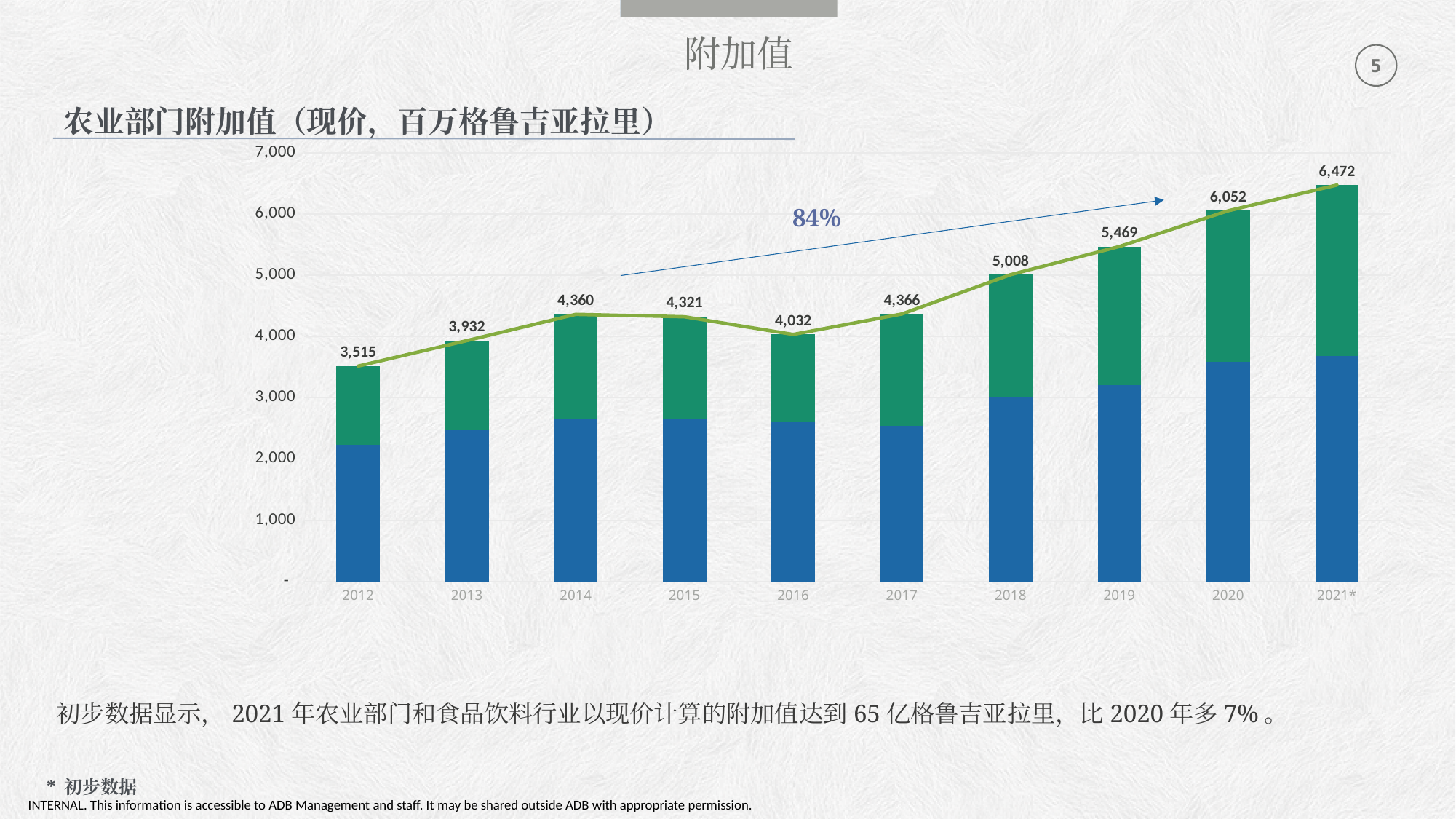
What is the difference between the total values for 2020 and 2019? 583 What kind of chart is this? Stacked bar chart with a line Which year has the lowest total value? 2012 What is the total value shown for 2018? 5,008 Do the total values generally rise or fall from 2016 to 2021*? rise Is the blue (bottom) segment of the 2012 bar greater or less than 3,000? less Which year has the highest total value? 2021* Which is larger, the total value for 2014 or for 2015? 2014 What percentage is written next to the arrow annotation on the chart? 84% What is the total value shown for 2021*? 6,472 What is the total value shown for 2012? 3,515 How many years are shown on the x axis? 10